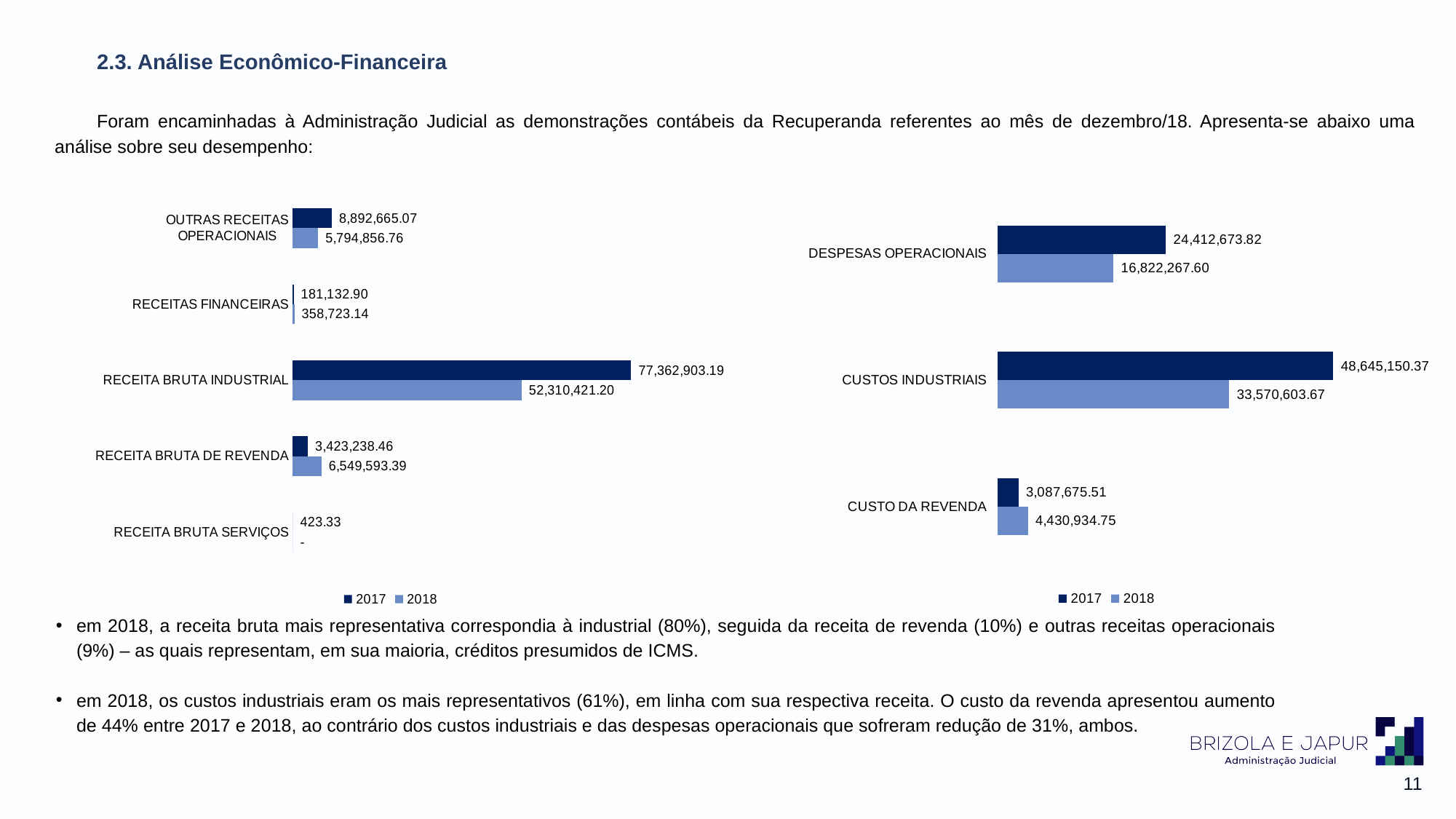
In the right chart, what is the 2017 value for DESPESAS OPERACIONAIS? 24,412,673.82 In the right chart, which category has the lowest 2017 value? CUSTO DA REVENDA In the right chart, which is larger for CUSTO DA REVENDA: the 2017 value or the 2018 value? 2018 How many series does the legend of the right chart list? 2 How many categories does the left chart show? 5 In the left chart, what is the 2017 value for RECEITA BRUTA INDUSTRIAL? 77,362,903.19 In the left chart, which category has the highest 2018 value? RECEITA BRUTA INDUSTRIAL In the right chart, what is the 2018 value for CUSTOS INDUSTRIAIS? 33,570,603.67 What type of chart is the right chart? Bar chart In the left chart, what is the 2018 value for RECEITA BRUTA DE REVENDA? 6,549,593.39 In the left chart, what is the difference between the 2017 and 2018 values for RECEITA BRUTA INDUSTRIAL? 25,052,481.99 In the right chart, what is the difference between the 2017 and 2018 values for CUSTOS INDUSTRIAIS? 15,074,546.70